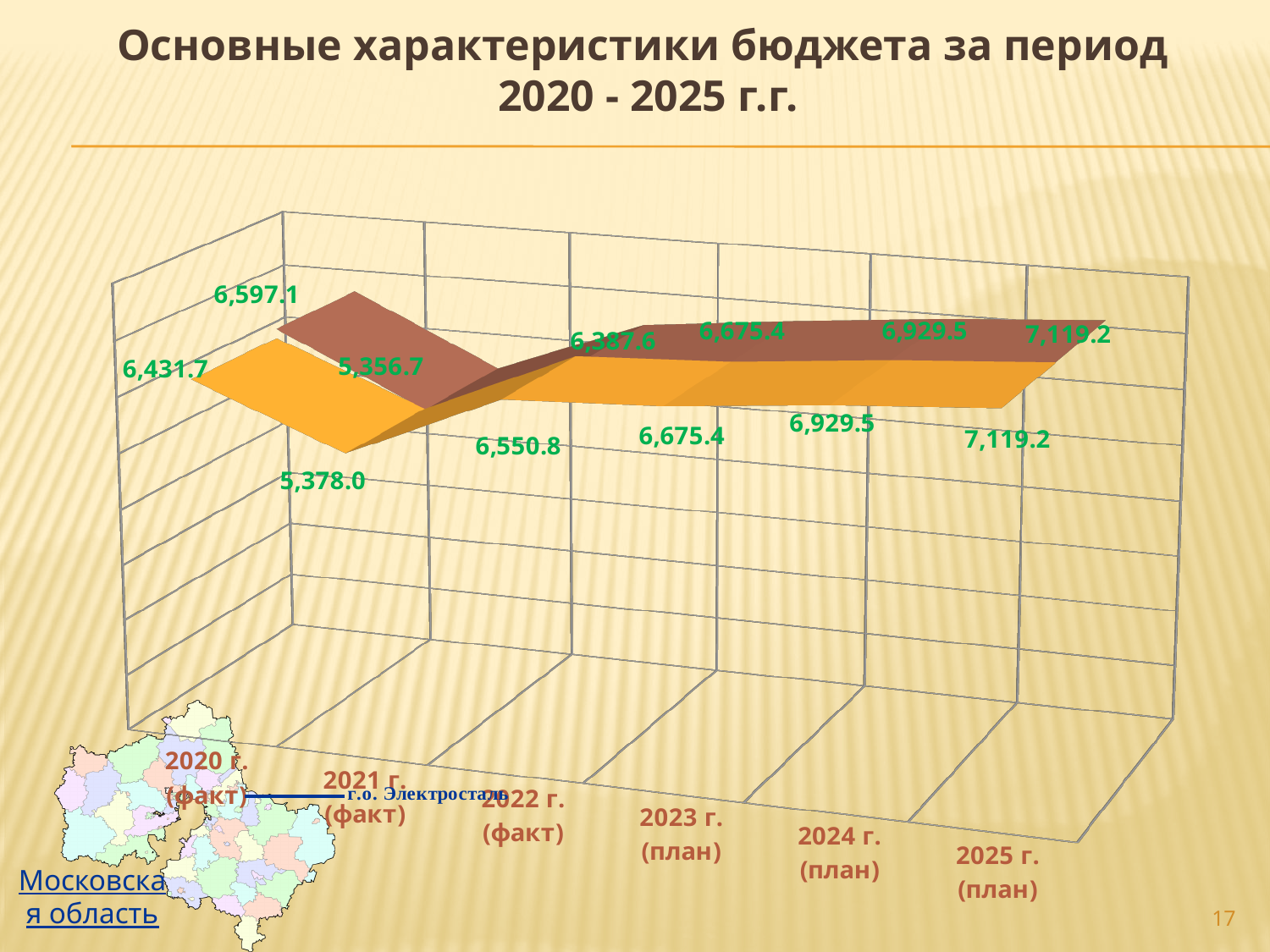
What is the value of the back brown series for 2020 г. (факт)? 6,597.1 Do the values of the front orange series rise or fall from 2021 г. (факт) to 2025 г. (план)? rise How many years (categories) are shown on the x axis? 6 What value is shown for 2025 г. (план)? 7,119.2 What is the value of the back brown series for 2022 г. (факт)? 6,387.6 What is the difference between the back brown series and the front orange series for 2020 г. (факт)? 165.4 What is the value of the front orange series for 2021 г. (факт)? 5,378.0 Which year has the lowest value in the front orange series? 2021 г. (факт) What is the value of the front orange series for 2020 г. (факт)? 6,431.7 Which year has the highest value in the back brown series? 2025 г. (план) What is the difference between the front orange series values for 2025 г. (план) and 2021 г. (факт)? 1,741.2 For 2022 г. (факт), which series has the larger value, the front orange series or the back brown series? front orange series